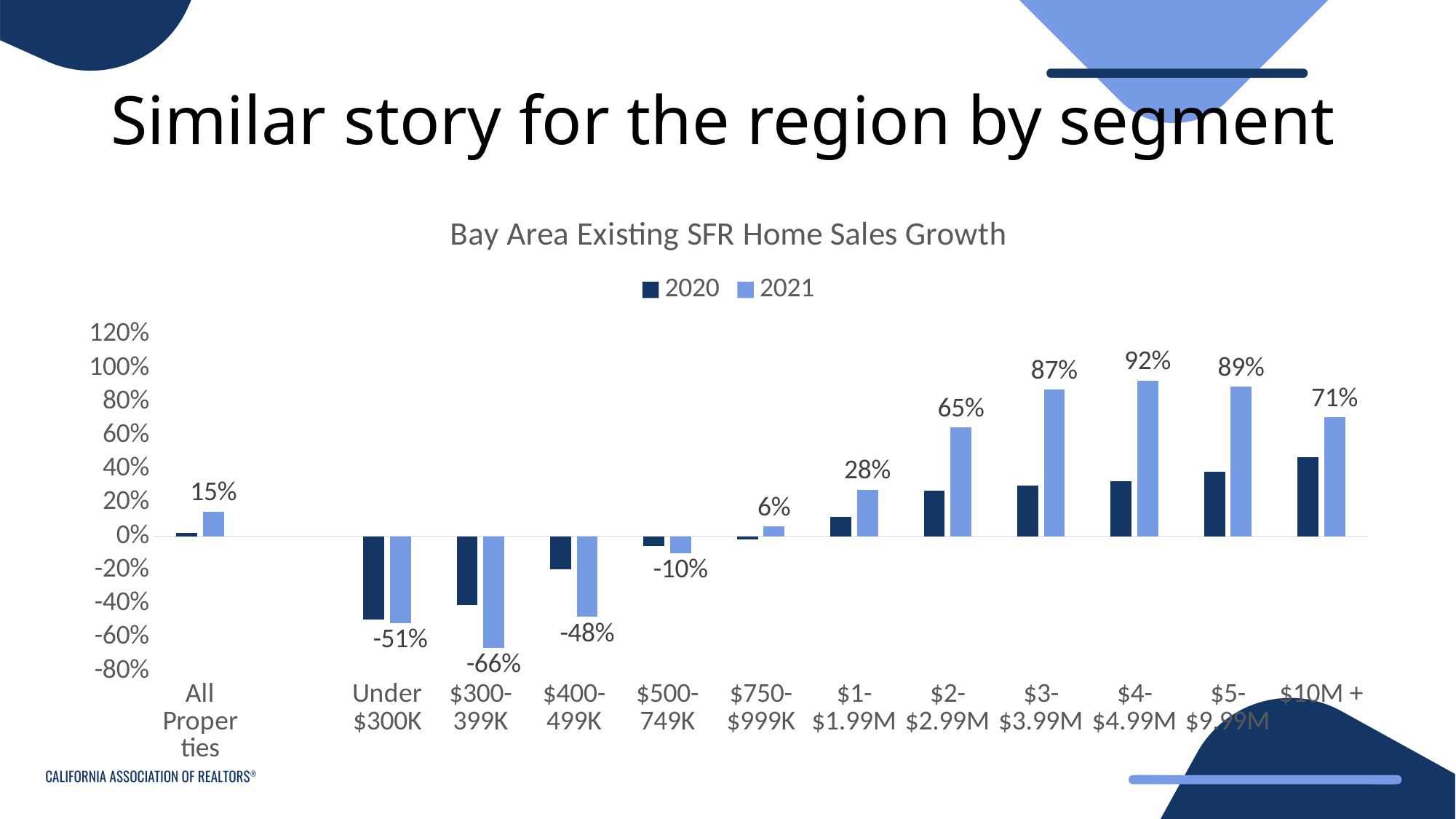
What is the 2021 value for All Properties? 15% What is the 2021 value for the $300-399K segment? -66% Is the 2020 value for the $10M + segment greater or less than 40%? greater Which segment has the lowest 2021 value? $300-399K What is the title of the chart? Bay Area Existing SFR Home Sales Growth What is the difference between the 2021 values for $3-$3.99M and $2-$2.99M? 22 percentage points Which is larger, the 2021 value for $5-$9.99M or for $10M +? $5-$9.99M How many series does the legend list? 2 Which segment has the highest 2021 value? $4-$4.99M How many price segment categories are shown on the x axis? 11 What type of chart is shown on the slide? bar chart What is the 2021 value for the $4-$4.99M segment? 92%